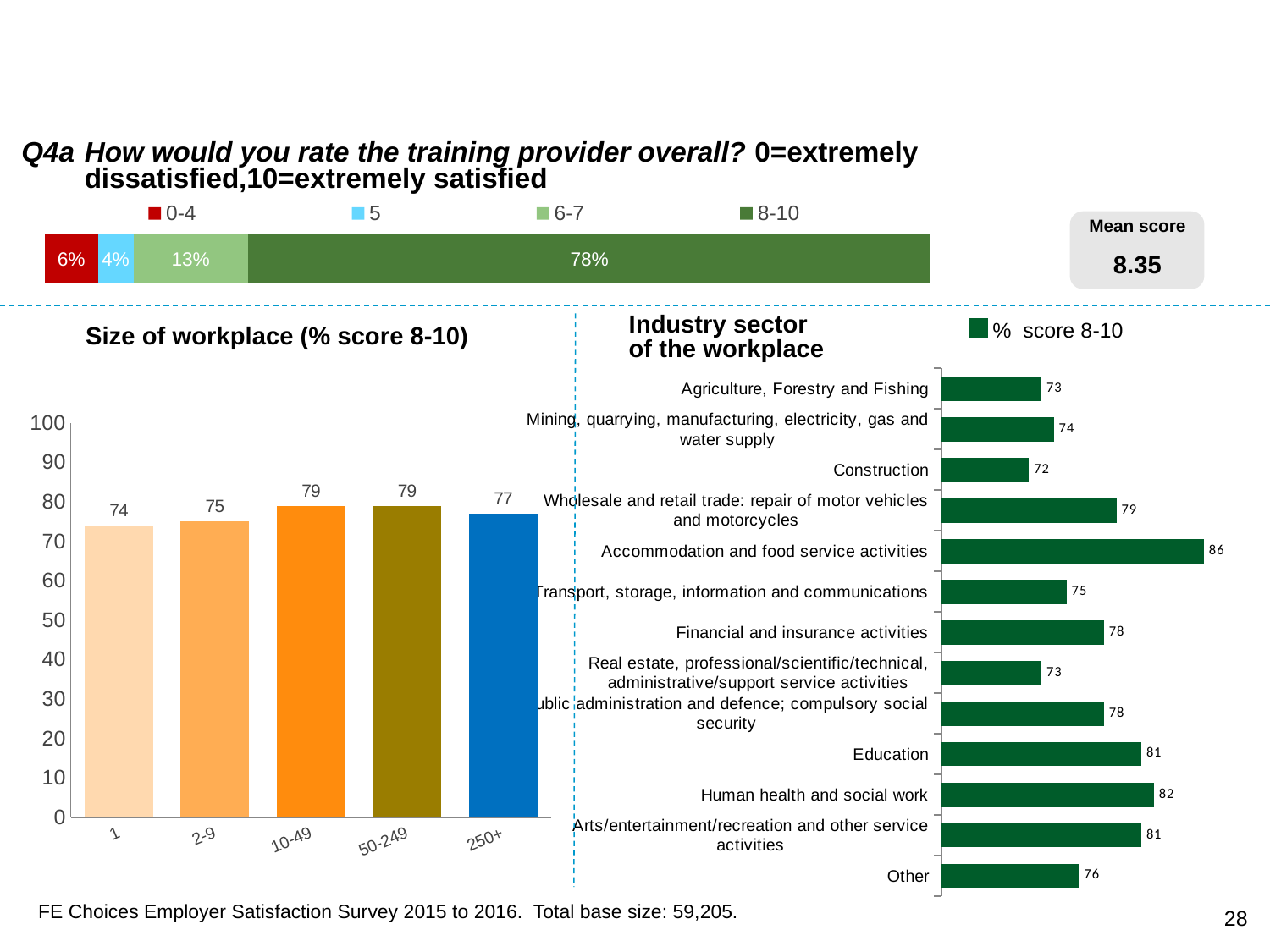
In the 'Size of workplace (% score 8-10)' chart, which workplace size has the lowest value? 1 In the 'Size of workplace (% score 8-10)' chart, what is the value for workplaces of size 250+? 77 In the 'Industry sector of the workplace' chart, which sector has the highest % score 8-10? Accommodation and food service activities In the 'Industry sector of the workplace' chart, which sector has the lowest % score 8-10? Construction In the stacked bar at the top of the slide, what percentage of respondents gave a score of 8-10? 78% In the 'Size of workplace (% score 8-10)' chart, what is the difference between the values for 10-49 and 1? 5 In the 'Industry sector of the workplace' chart, which is larger: the value for Human health and social work or the value for Financial and insurance activities? Human health and social work In the 'Size of workplace (% score 8-10)' chart, how many workplace size categories are shown? 5 What kind of chart is the 'Size of workplace (% score 8-10)' chart? bar chart In the 'Industry sector of the workplace' chart, what is the value for Education? 81 How many series does the legend of the stacked bar at the top of the slide list? 4 In the 'Industry sector of the workplace' chart, how many sectors are listed? 13